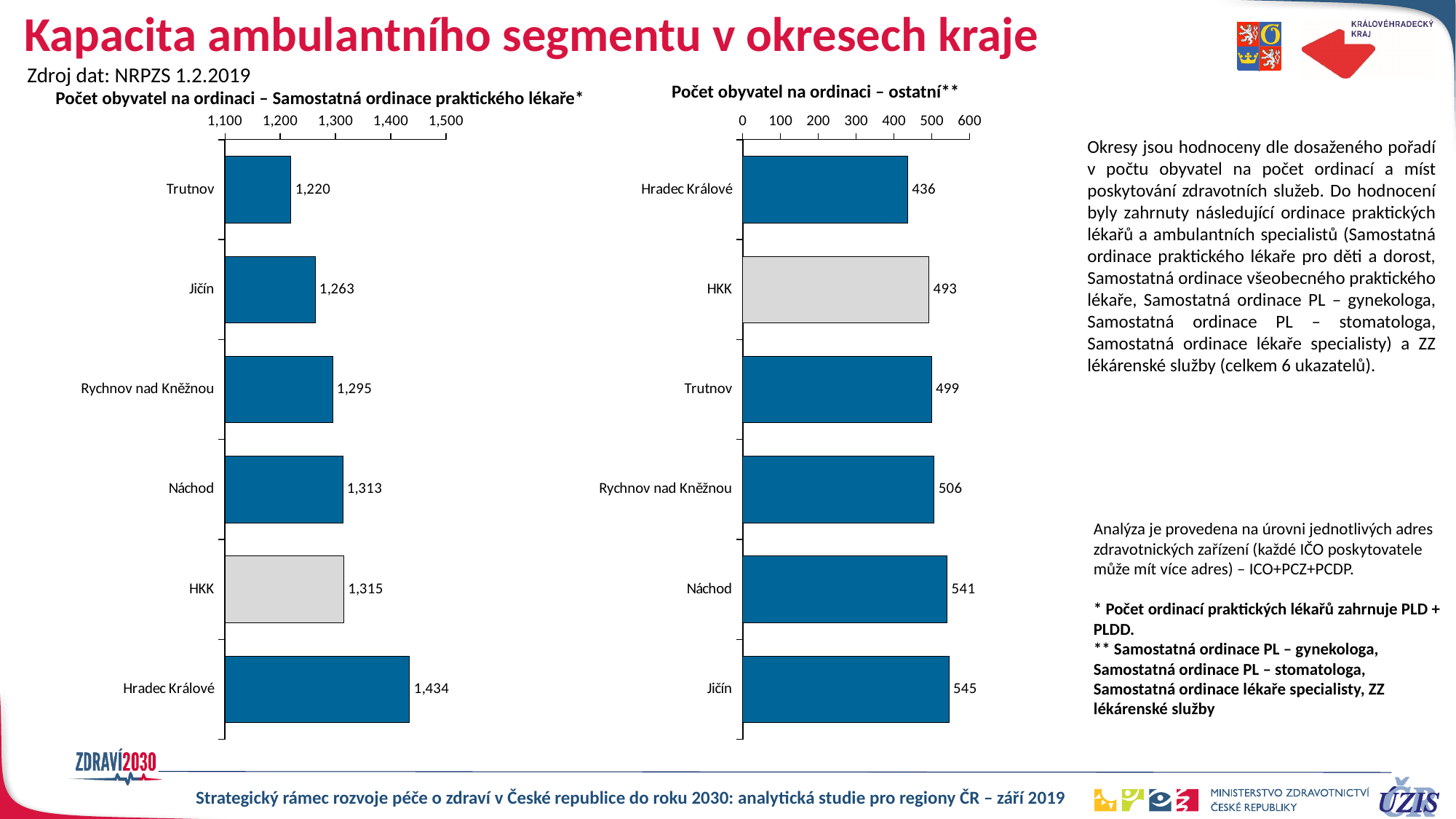
In the right chart (ostatní), what is the difference between Jičín and Hradec Králové? 109 In the left chart (Samostatná ordinace praktického lékaře), what is the difference between Hradec Králové and Trutnov? 214 In the right chart (ostatní), which is larger: the value for Trutnov or the value for Náchod? Náchod In the left chart (Samostatná ordinace praktického lékaře), which category has the lowest value? Trutnov In the left chart (Samostatná ordinace praktického lékaře), what is the value for Trutnov? 1,220 What type of chart is the right chart (ostatní)? Bar chart In the left chart (Samostatná ordinace praktického lékaře), which category is shown with a grey bar instead of blue? HKK In the left chart (Samostatná ordinace praktického lékaře), how many categories are shown? 6 In the right chart (ostatní), what is the value for Náchod? 541 In the left chart (Samostatná ordinace praktického lékaře), which category has the highest value? Hradec Králové In the right chart (ostatní), which category has the highest value? Jičín In the right chart (ostatní), which category has the lowest value? Hradec Králové